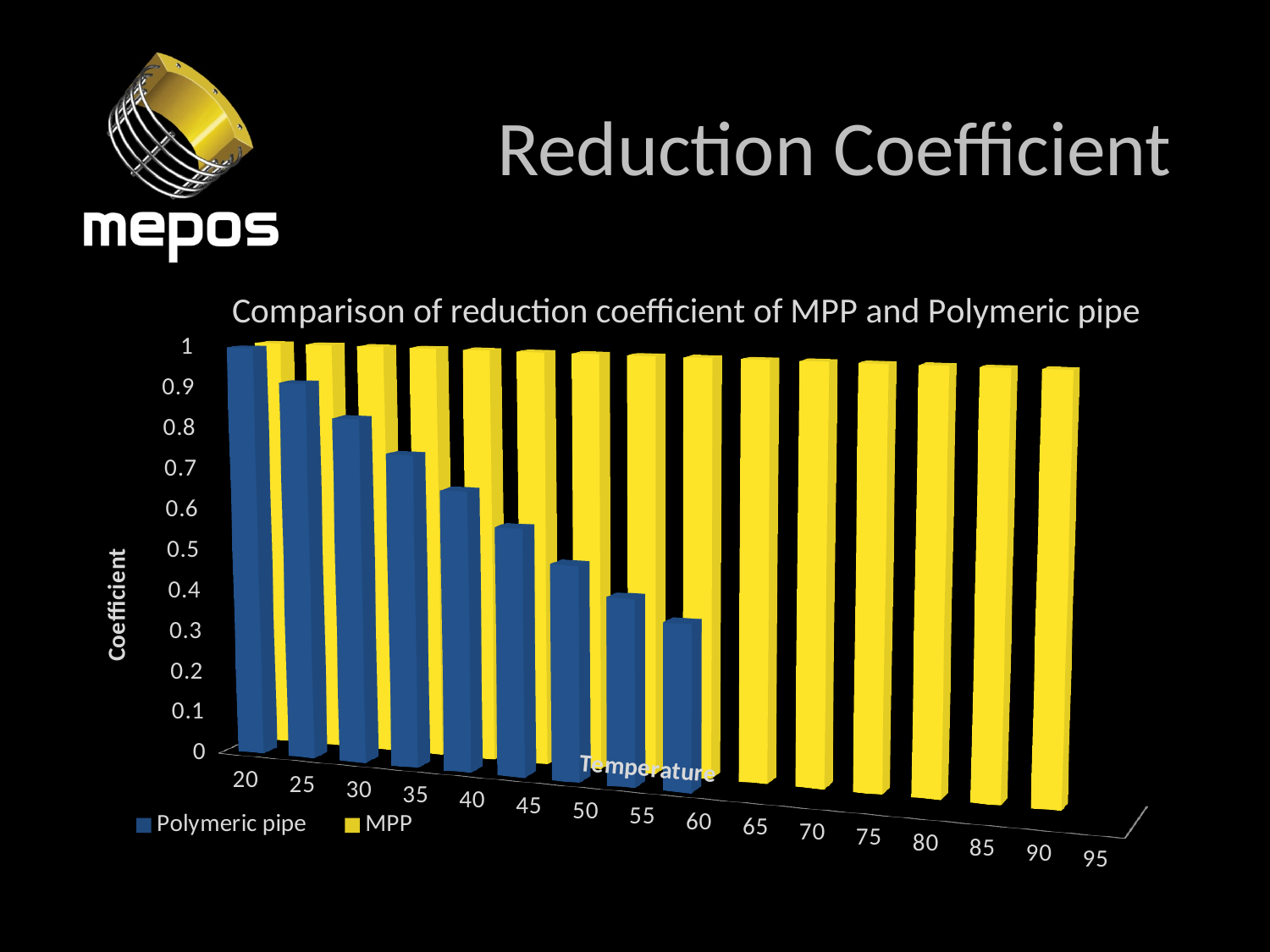
What is the title of the chart? Comparison of reduction coefficient of MPP and Polymeric pipe Is the Polymeric pipe coefficient at temperature 60 greater or less than 0.5? less At temperature 60, which series has the larger coefficient, Polymeric pipe or MPP? MPP What kind of chart is shown on the slide? Bar chart How many series does the legend list? 2 What are the two series named in the legend? Polymeric pipe and MPP Does the Polymeric pipe coefficient rise or fall as temperature increases? Fall Is the Polymeric pipe coefficient at temperature 40 greater or less than 0.5? greater How many temperature categories are shown on the x axis? 16 At which temperature is the Polymeric pipe coefficient highest? 20 At which temperature is the Polymeric pipe coefficient lowest? 60